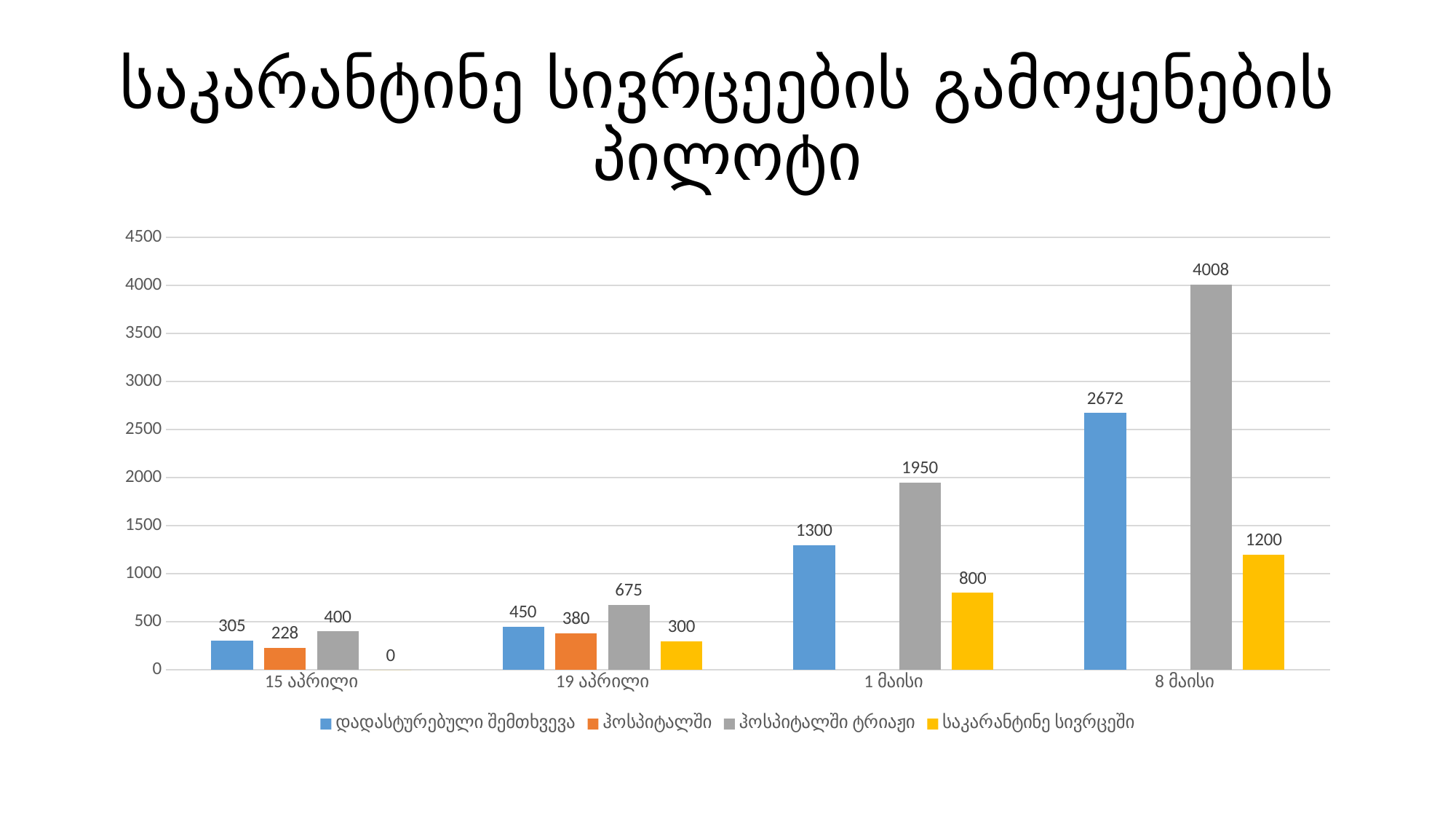
How many dates are shown on the x axis? 4 What is the value for საკარანტინე სივრცეში on 15 აპრილი? 0 Which date has the highest value for ჰოსპიტალში ტრიაჟი? 8 მაისი Do the values for საკარანტინე სივრცეში rise or fall from 15 აპრილი to 8 მაისი? Rise Which is larger on 1 მაისი: დადასტურებული შემთხვევა or საკარანტინე სივრცეში? დადასტურებული შემთხვევა What kind of chart is shown on the slide? Bar chart What is the difference between ჰოსპიტალში ტრიაჟი and დადასტურებული შემთხვევა on 8 მაისი? 1336 What is the value for ჰოსპიტალში on 19 აპრილი? 380 Which date has the lowest value for დადასტურებული შემთხვევა? 15 აპრილი How many series does the legend list? 4 What is the value for ჰოსპიტალში ტრიაჟი on 1 მაისი? 1950 What is the value for დადასტურებული შემთხვევა on 8 მაისი? 2672